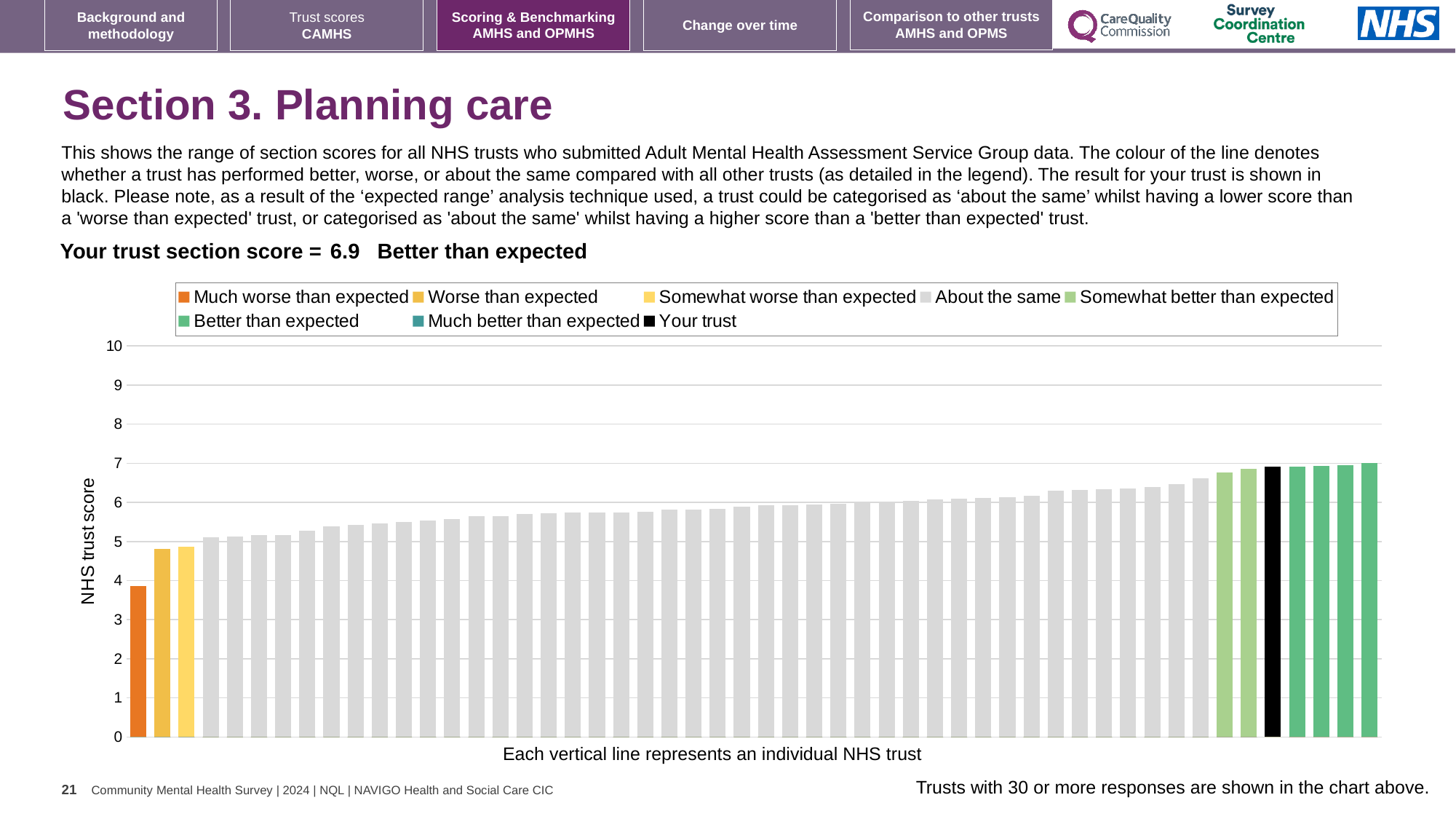
Is the value of the lowest bar greater or less than 4? less How many entries does the chart legend list? 8 Which legend category do the highest bars in the chart belong to? Better than expected Is the value for your trust greater or less than 6? greater What is the section score for your trust? 6.9 Which legend category does the lowest bar in the chart belong to? Much worse than expected Is the value of the highest bar greater or less than 8? less What colour is the bar representing your trust? black How many bars are coloured as 'Much worse than expected'? 1 What kind of chart is shown on the slide? bar chart Which is higher: the bar for your trust or the orange 'Much worse than expected' bar? Your trust Do the bar values rise or fall from left to right along the x axis? rise